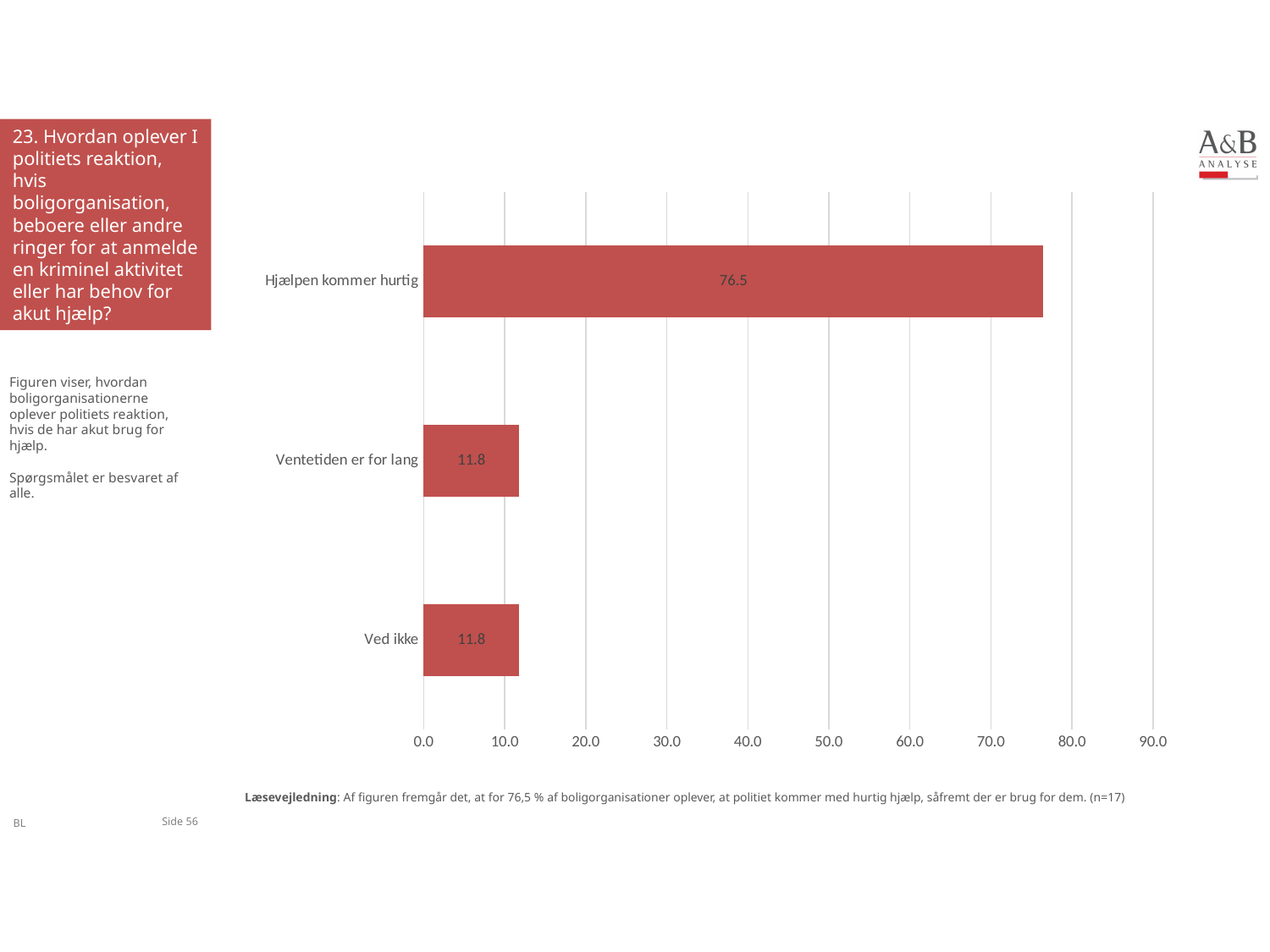
What is the highest tick value shown on the horizontal axis? 90.0 What colour are the bars in the chart? red What is the difference between the values for "Hjælpen kommer hurtig" and "Ventetiden er for lang"? 64.7 Which is larger, the value for "Hjælpen kommer hurtig" or the value for "Ved ikke"? Hjælpen kommer hurtig What is the value for "Hjælpen kommer hurtig"? 76.5 Is the value for "Hjælpen kommer hurtig" greater or less than 70.0? greater What kind of chart is shown on the slide? bar chart Which category has the highest value? Hjælpen kommer hurtig Is the value for "Ved ikke" greater or less than 20.0? less What is the value for "Ved ikke"? 11.8 How many categories are shown in the chart? 3 What is the value for "Ventetiden er for lang"? 11.8